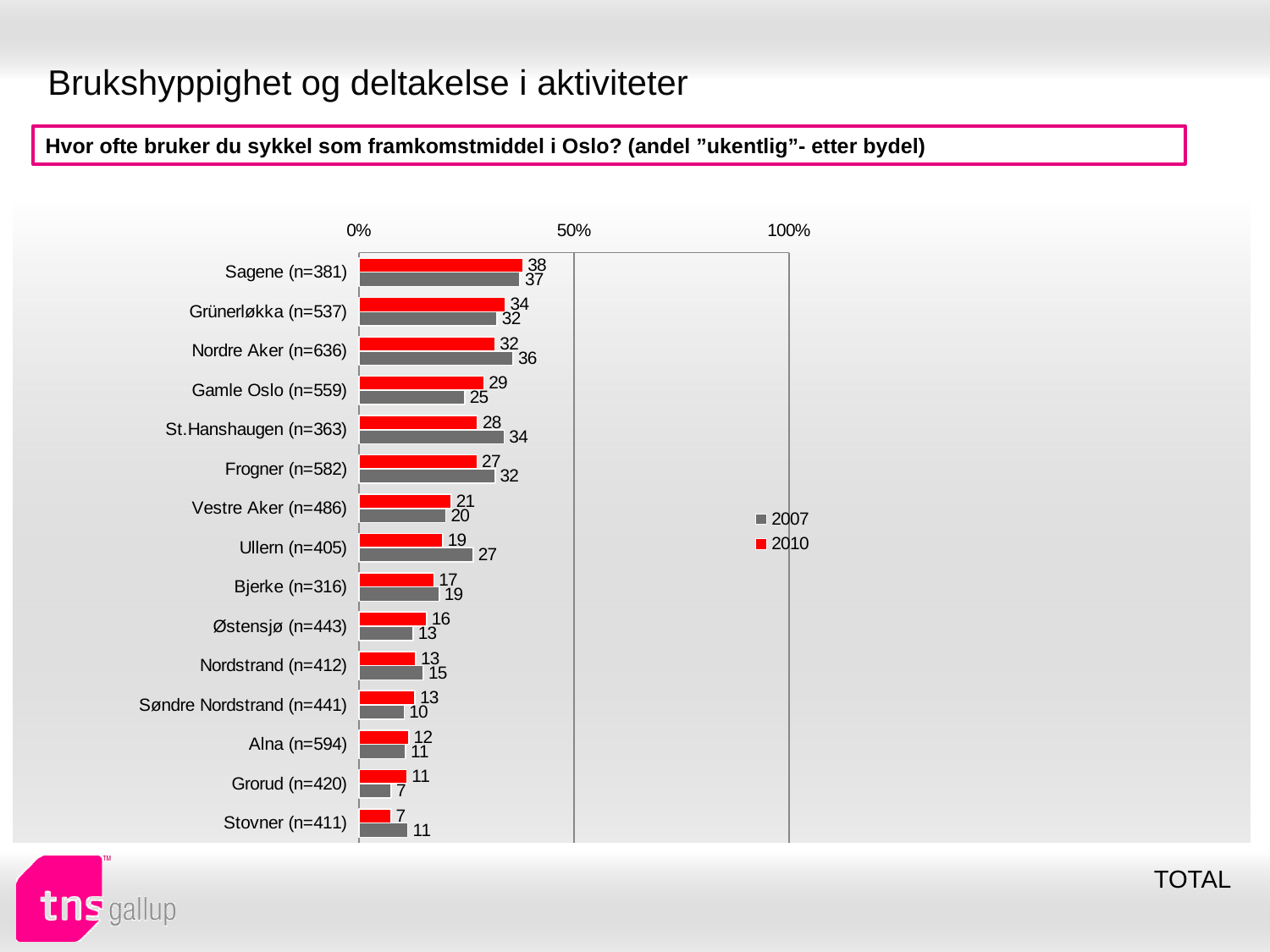
What kind of chart is shown on the slide? Bar chart What is the 2010 value for Sagene (n=381)? 38 Which bydel has the lowest 2010 value? Stovner (n=411) What is the 2007 value for Ullern (n=405)? 27 Which is larger for Grorud (n=420): the 2007 value or the 2010 value? 2010 How many series does the legend list? 2 How many bydeler are shown on the chart? 15 Is the 2010 value for Gamle Oslo (n=559) greater or less than 50%? less Which colour represents the 2010 series in the chart? Red Which bydel has the highest 2010 value? Sagene (n=381) What is the 2007 value for Nordre Aker (n=636)? 36 What is the difference between the 2007 and 2010 values for St.Hanshaugen (n=363)? 6